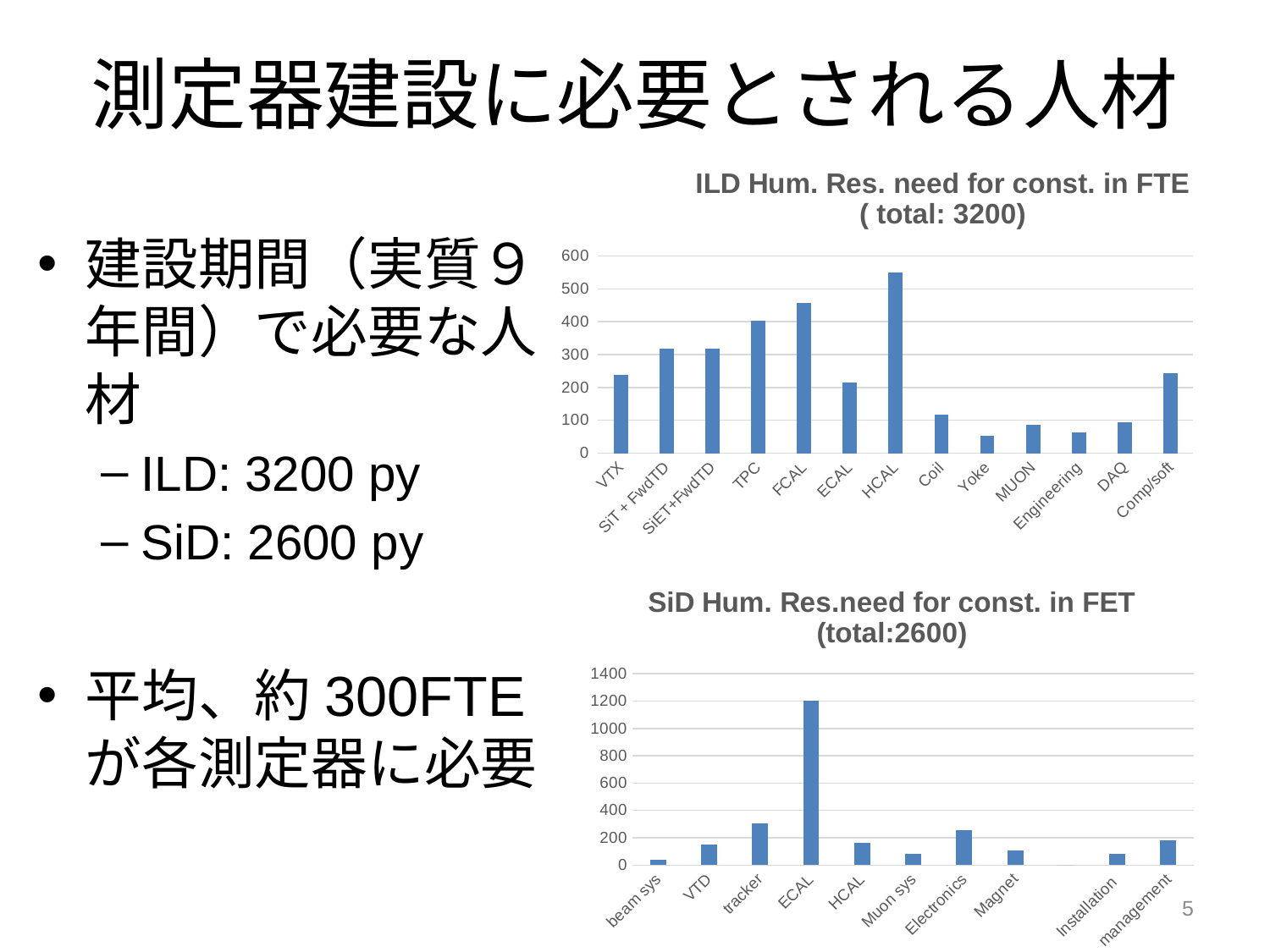
In the ILD Hum. Res. need for const. chart, which category has the lowest value? Yoke How many categories are shown in the ILD Hum. Res. need for const. chart? 13 In the ILD Hum. Res. need for const. chart, is the value for Coil greater or less than 200? less In the ILD Hum. Res. need for const. chart, is the value for FCAL greater or less than 400? greater In the SiD Hum. Res. need for const. chart, which category has the highest value? ECAL In the SiD Hum. Res. need for const. chart, which is larger, the value for Electronics or the value for Magnet? Electronics In the SiD Hum. Res. need for const. chart, is the value for tracker greater or less than 200? greater In the ILD Hum. Res. need for const. chart, which is larger, the value for TPC or the value for ECAL? TPC What type of chart is the ILD Hum. Res. need for const. chart? bar chart In the SiD Hum. Res. need for const. chart, which category has the lowest value? beam sys What total is stated in the title of the SiD Hum. Res. need for const. chart? 2600 In the ILD Hum. Res. need for const. chart, which category has the highest value? HCAL